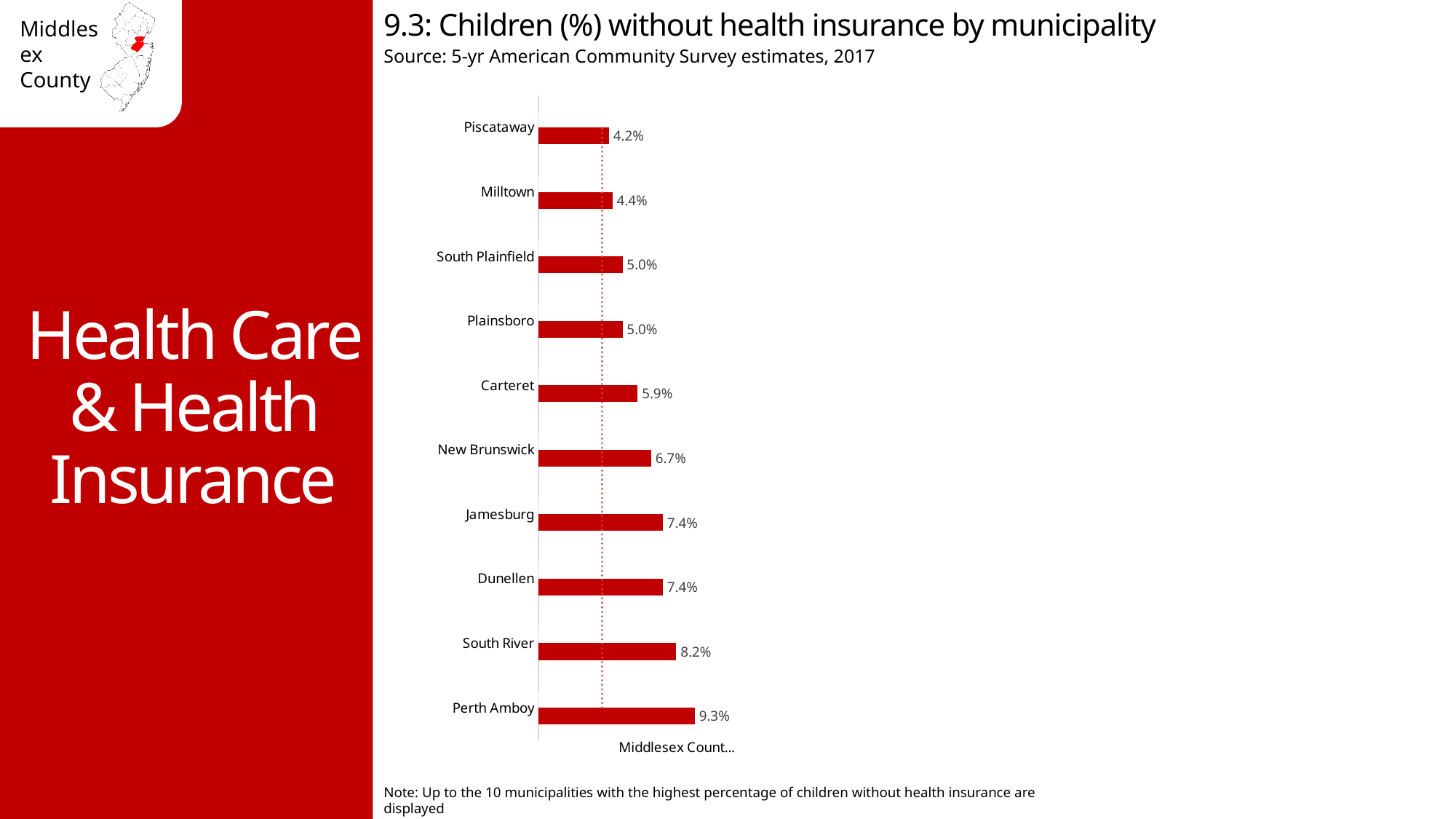
What is the value shown for Milltown? 4.4% What percentage of children in Perth Amboy are without health insurance? 9.3% Which has a higher value, Carteret or South Plainfield? Carteret What is the value shown for Carteret? 5.9% Which municipality has the lowest percentage of children without health insurance? Piscataway How many municipalities are shown in the chart? 10 Which has a higher value, South River or Jamesburg? South River What type of chart is used on this slide? Bar chart Which municipality has the highest percentage of children without health insurance? Perth Amboy What is the difference between the values for Perth Amboy and South River? 1.1% What is the source of the data shown in the chart? 5-yr American Community Survey estimates, 2017 What is the difference between the values for New Brunswick and Piscataway? 2.5%